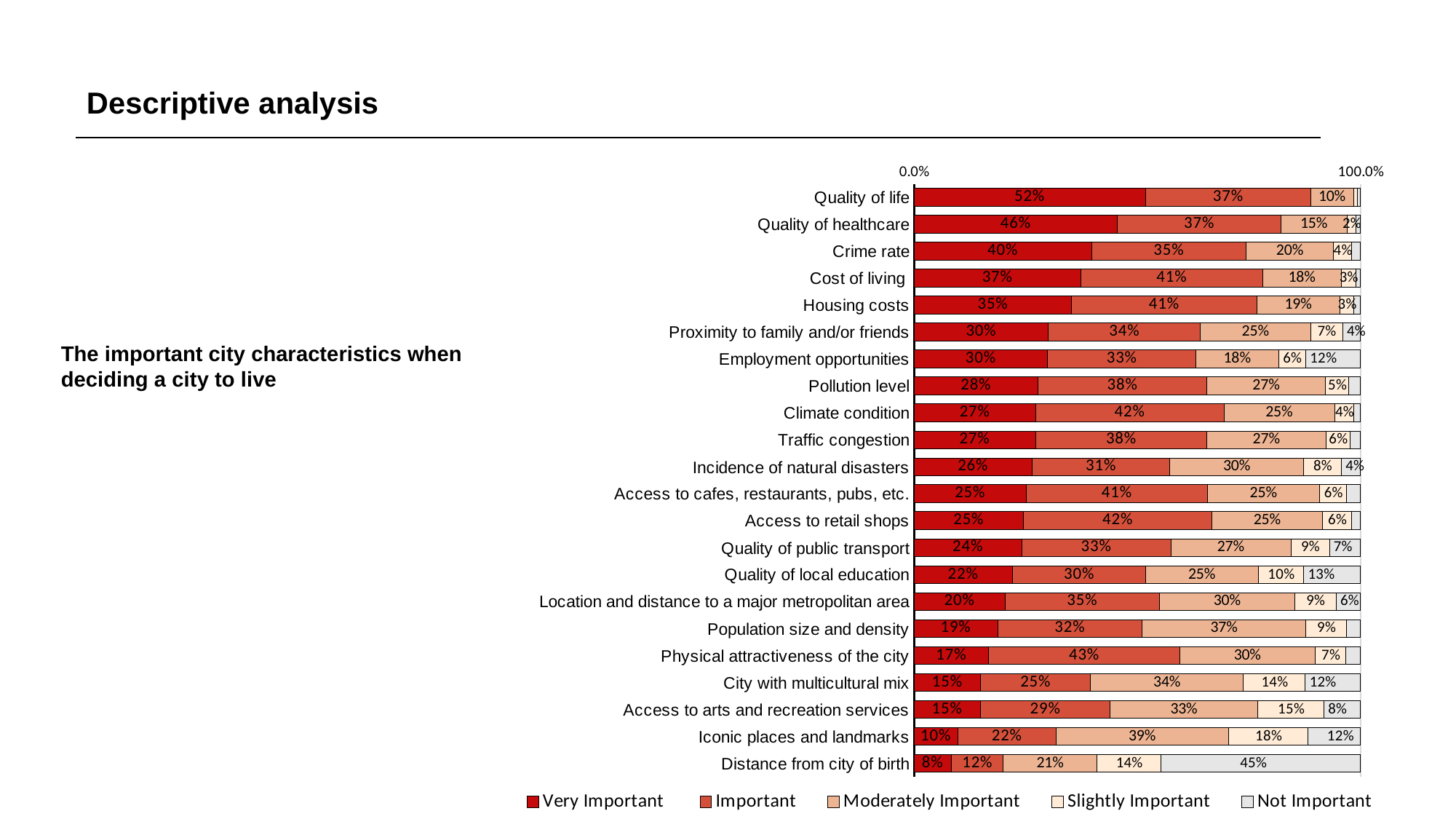
What kind of chart is shown on the slide? Stacked bar chart Which characteristic has the lowest Very Important percentage? Distance from city of birth Which has a larger Very Important value, Crime rate or Cost of living? Crime rate What is the Not Important value for Distance from city of birth? 45% What is the difference between the Very Important values for Quality of life and Quality of healthcare? 6 percentage points Which legend entry is shown in the darkest red colour? Very Important What is the Important value for Physical attractiveness of the city? 43% How many series does the legend list? 5 Which characteristic has the highest Very Important percentage? Quality of life What percentage of respondents rated Quality of life as Very Important? 52% How many city characteristics (categories) are plotted in the chart? 22 What is the Moderately Important value for Iconic places and landmarks? 39%